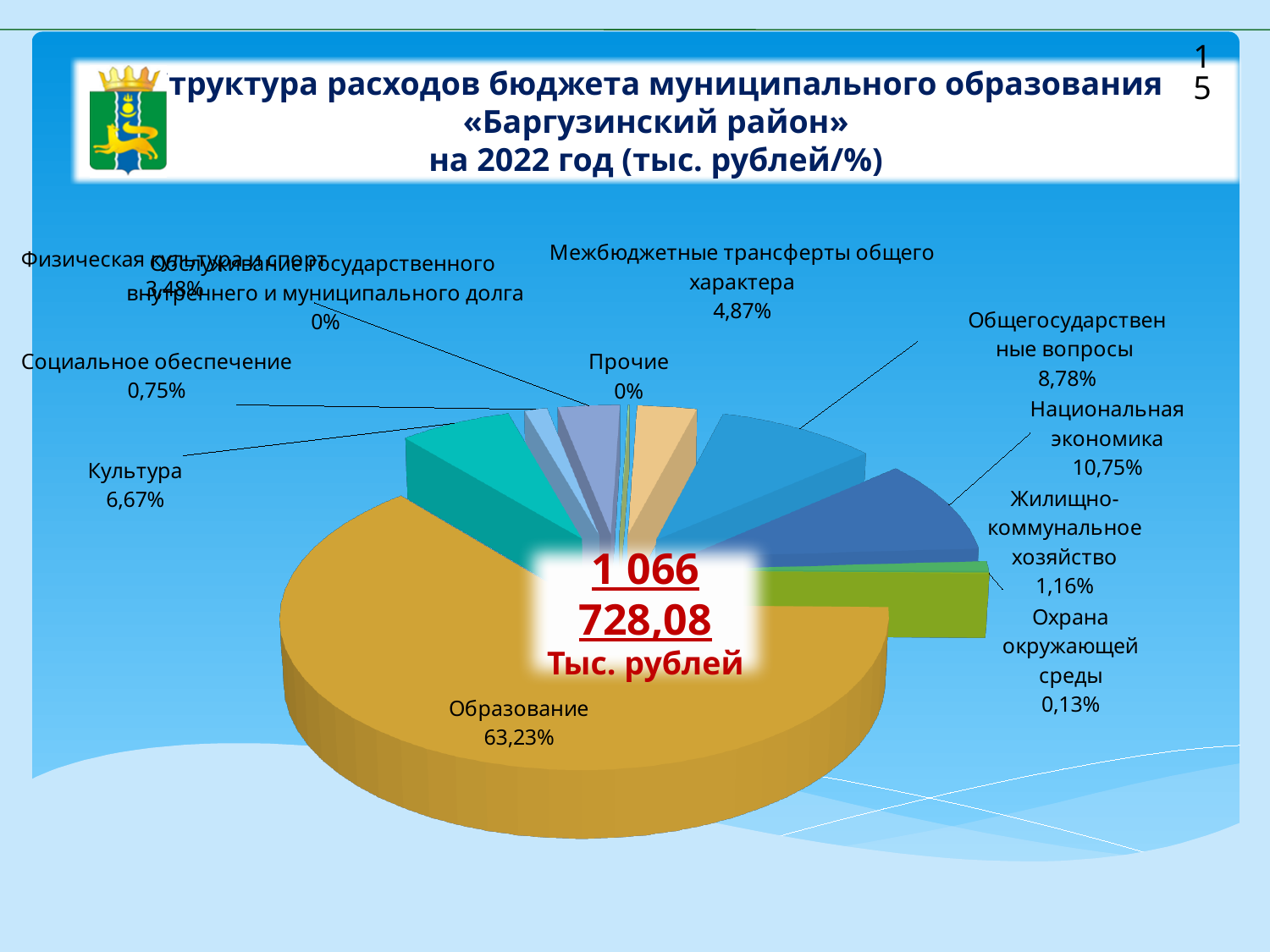
What is the value shown for Межбюджетные трансферты общего характера? 4,87% What kind of chart is shown on the slide? Pie chart What is the difference between the shares of Национальная экономика and Общегосударственные вопросы? 1,97% Which is larger, Культура or Межбюджетные трансферты общего характера? Культура Which category has the largest share of the pie? Образование What is the value shown for Национальная экономика? 10,75% What is the value shown for Охрана окружающей среды? 0,13% What is the value shown for Жилищно-коммунальное хозяйство? 1,16% What share of the budget expenditure does Образование account for? 63,23% What is the value shown for Социальное обеспечение? 0,75% What is the value shown for Общегосударственные вопросы? 8,78% What is the value shown for Культура? 6,67%